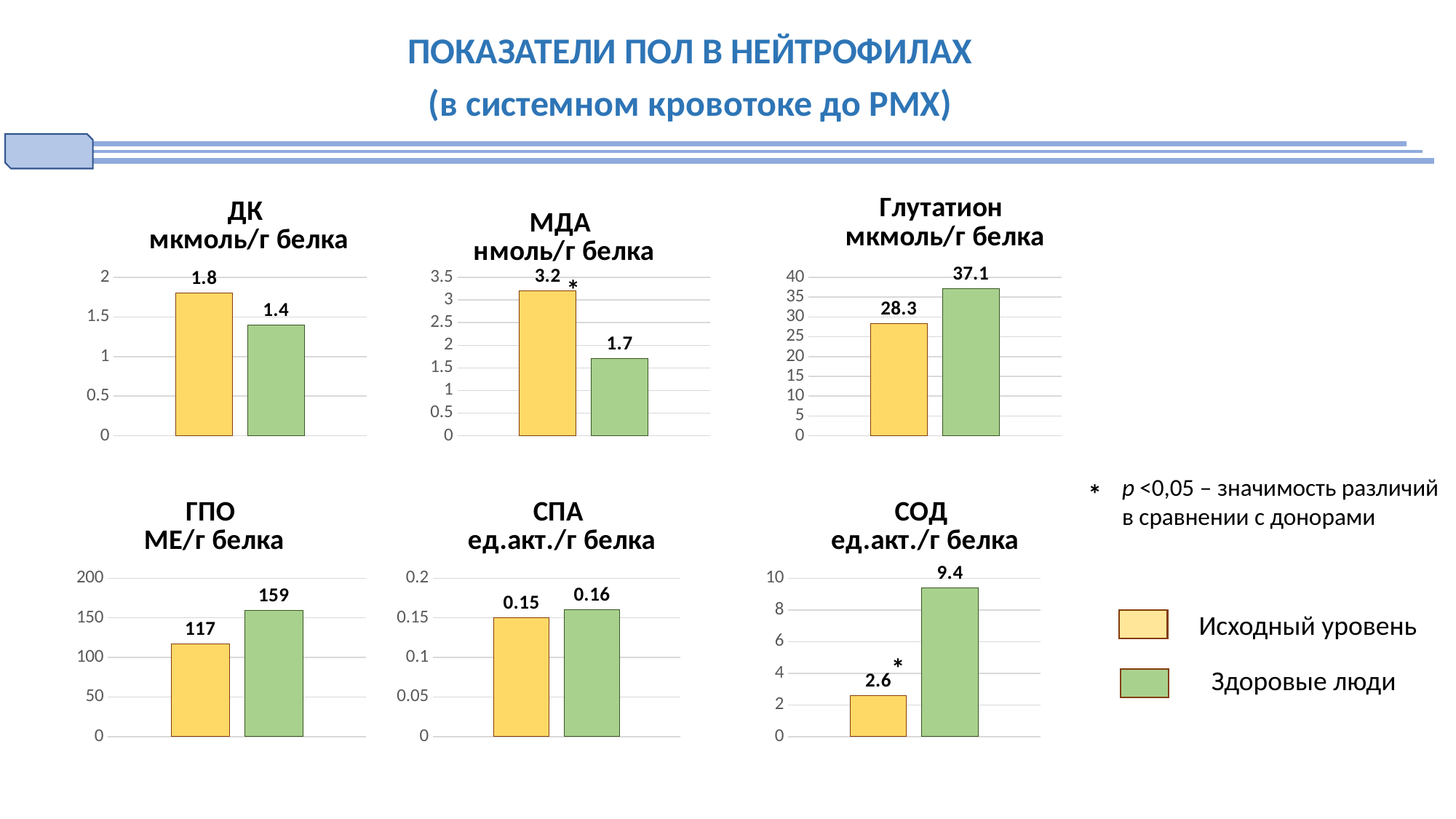
In the Глутатион chart, what is the value for Здоровые люди? 37.1 In the МДА chart, what is the difference between the Исходный уровень value and the Здоровые люди value? 1.5 In the СПА chart, what is the value for Исходный уровень? 0.15 Which series does the green colour represent in the legend? Здоровые люди How many bars does the ДК chart have? 2 In the СОД chart, which bar is higher, Исходный уровень or Здоровые люди? Здоровые люди In the ГПО chart, what is the difference between the Здоровые люди value and the Исходный уровень value? 42 In the МДА chart, what is the value for Здоровые люди? 1.7 In the Глутатион chart, which bar is lower, Исходный уровень or Здоровые люди? Исходный уровень What kind of chart is the ГПО chart? Bar chart In the СОД chart, what is the value for Исходный уровень? 2.6 In the ДК chart, what is the value for Исходный уровень? 1.8